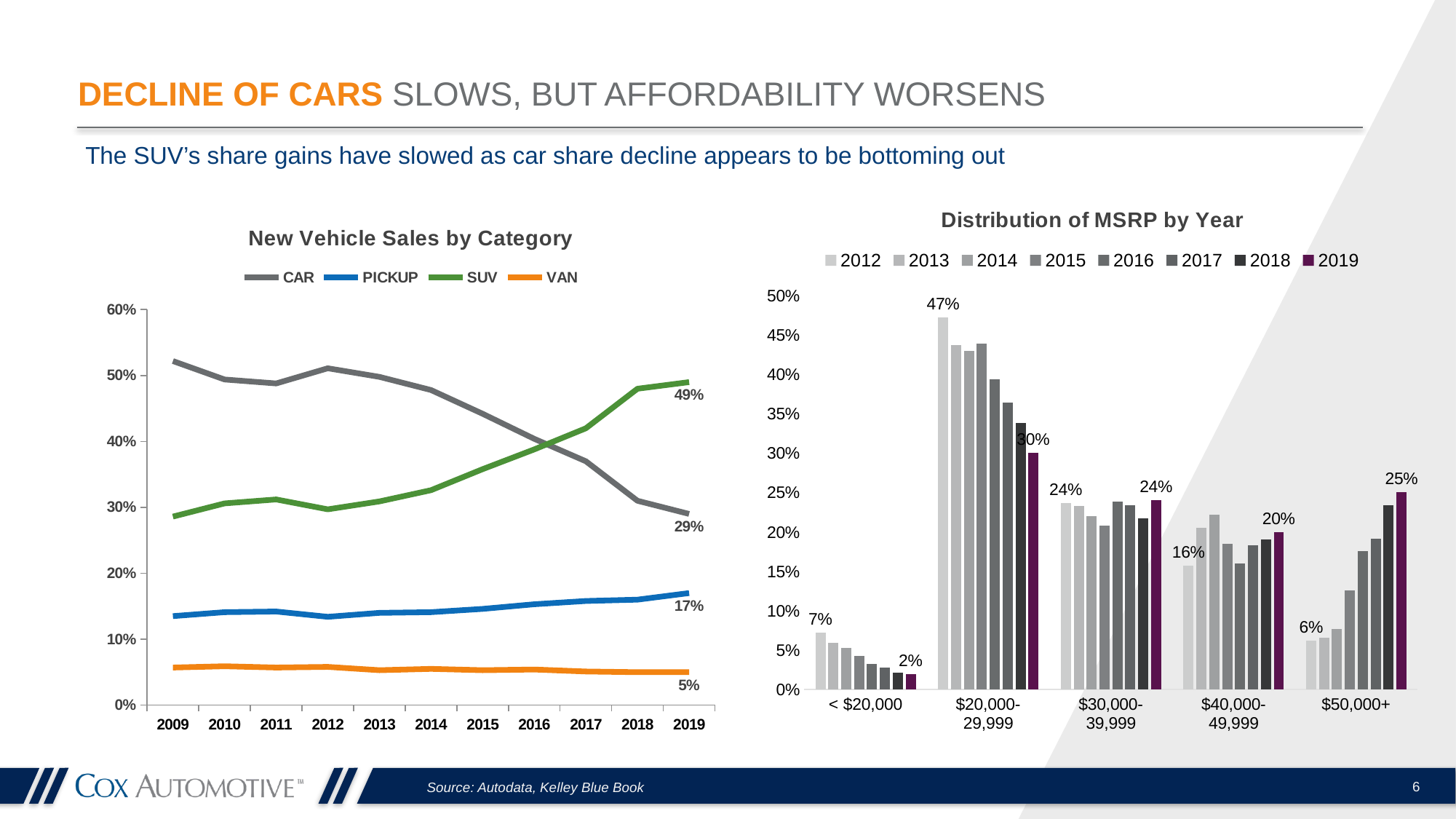
In the 'Distribution of MSRP by Year' chart, what is the 2012 value for the $20,000-29,999 category? 47% In the 'New Vehicle Sales by Category' chart, does the CAR share rise or fall from 2009 to 2019? fall What kind of chart is 'Distribution of MSRP by Year'? bar chart In the 'Distribution of MSRP by Year' chart, how many MSRP categories are shown on the x axis? 5 In the 'Distribution of MSRP by Year' chart, what is the 2019 value for the $50,000+ category? 25% In the 'New Vehicle Sales by Category' chart, what is the SUV share in 2019? 49% In the 'New Vehicle Sales by Category' chart, what is the difference between the SUV and CAR shares in 2019? 20% In the 'New Vehicle Sales by Category' chart, is the CAR share in 2009 greater or less than 50%? greater In the 'Distribution of MSRP by Year' chart, which is larger for the $50,000+ category: the 2012 value or the 2019 value? 2019 In the 'New Vehicle Sales by Category' chart, how many series does the legend list? 4 In the 'New Vehicle Sales by Category' chart, what is the CAR share in 2019? 29% In the 'Distribution of MSRP by Year' chart, what is the difference between the 2012 and 2019 values for the $20,000-29,999 category? 17%